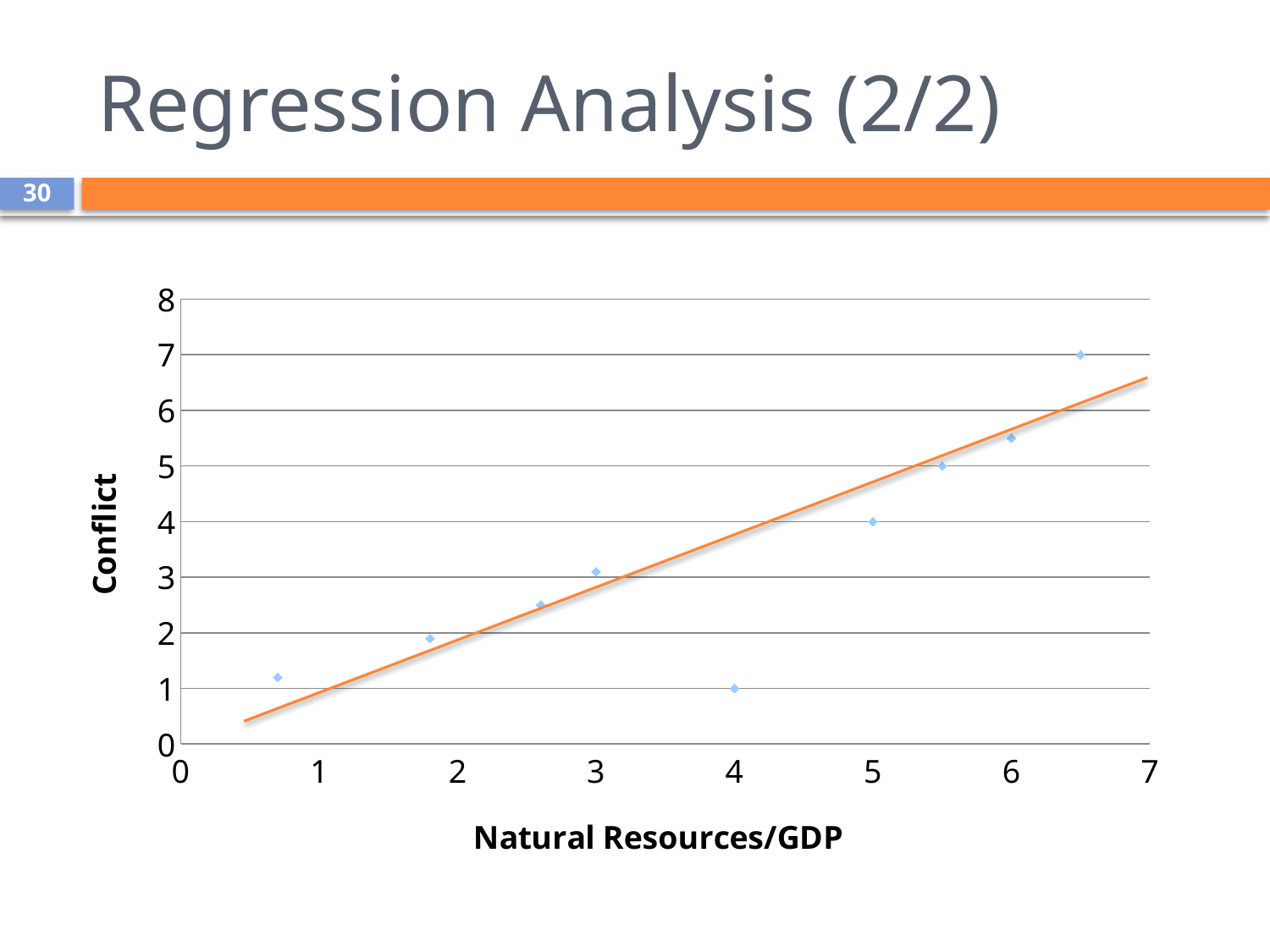
Which data point has the highest Conflict value? the rightmost point Is the Conflict value for the rightmost data point greater or less than 6? greater What is the title of the y axis? Conflict What is the Conflict value of the data point at Natural Resources/GDP = 4? 1 What is the Conflict value of the data point at Natural Resources/GDP = 5? 4 What is the title of the x axis? Natural Resources/GDP How many data points are plotted on the chart? 9 Which has the higher Conflict value: the data point at Natural Resources/GDP = 4 or the one at Natural Resources/GDP = 5? the point at 5 Is the Conflict value for the leftmost data point greater or less than 2? less What kind of chart is shown on the slide? scatter chart Is the Conflict value for the data point at Natural Resources/GDP of about 6 greater or less than 5? greater Do the Conflict values generally rise or fall as Natural Resources/GDP increases? rise